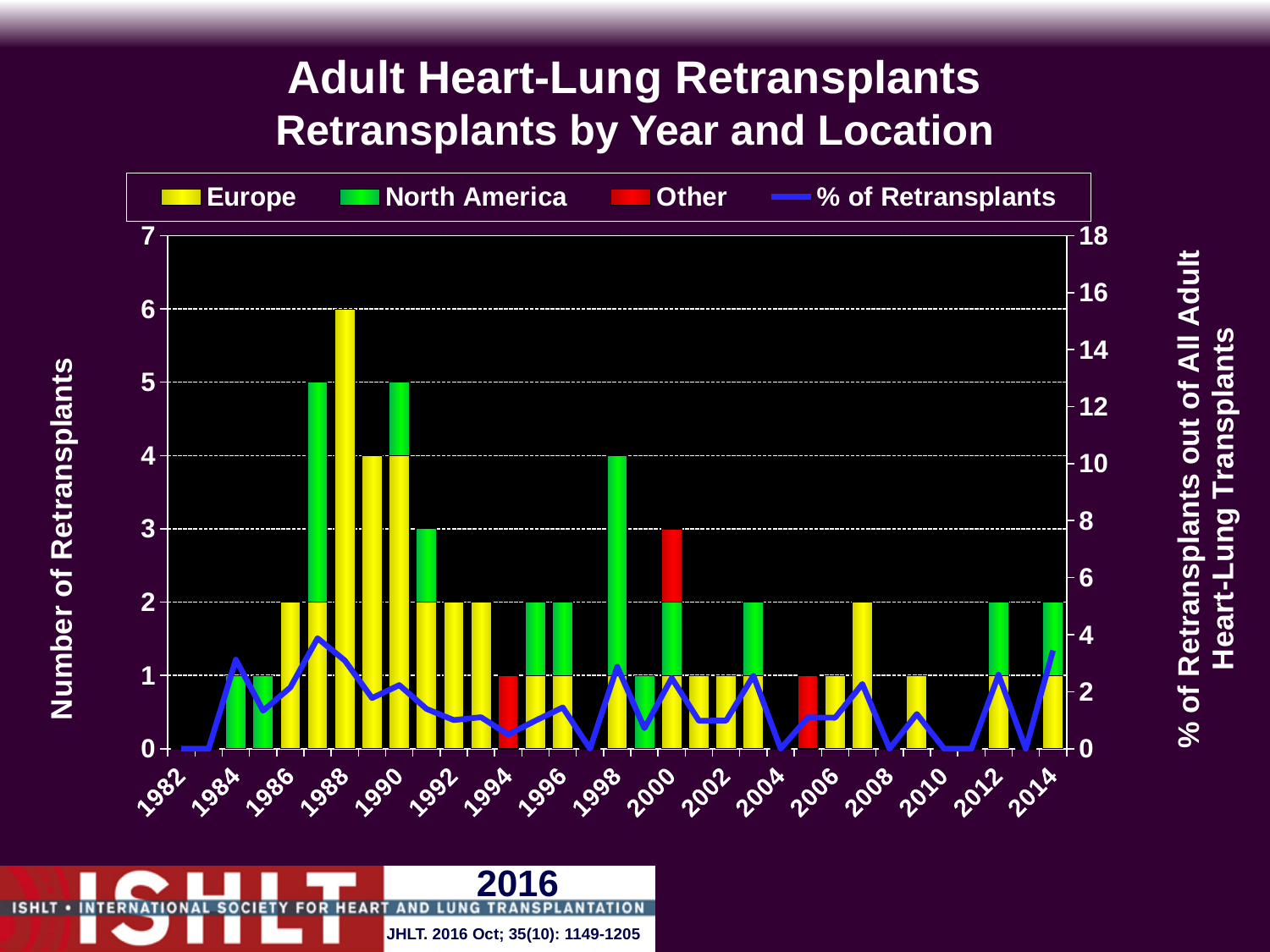
Is the % of Retransplants value for 1984 greater or less than 2? greater What type of chart is shown on the slide? Stacked bar chart with a line What is the total number of retransplants in 1990? 5 Which is larger, the total number of retransplants in 1998 or in 2000? 1998 What is the total number of retransplants in 1988? 6 How many series does the legend list? 4 What is the label of the right-hand vertical axis? % of Retransplants out of All Adult Heart-Lung Transplants How many retransplants in 1998 were in North America? 3 Which series is shown in red in the legend? Other How many retransplants in 1989 were in Europe? 4 Which year has the highest total number of retransplants? 1988 What is the difference between the total retransplants in 1988 and in 1986? 4